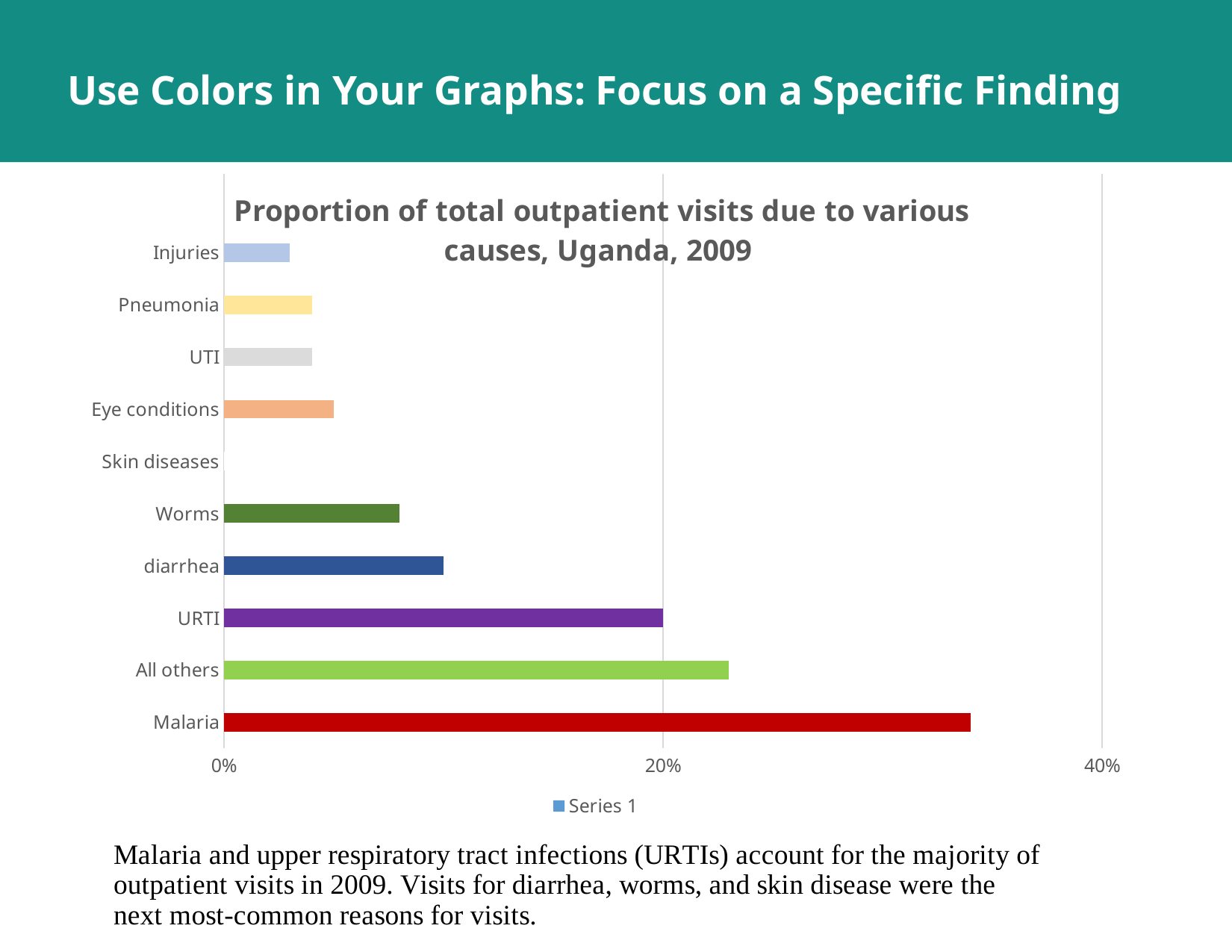
Is the value for Malaria greater or less than 20%? greater What is the title of the chart? Proportion of total outpatient visits due to various causes, Uganda, 2009 Is the value for diarrhea greater or less than 20%? less What kind of chart is shown on the slide? bar chart Which cause accounts for the highest proportion of outpatient visits? Malaria Is the value for Worms greater or less than 20%? less How many causes (categories) are shown in the chart? 10 Which is larger, the value for diarrhea or the value for Worms? diarrhea How many series does the legend list? 1 Which is larger, the value for Malaria or the value for All others? Malaria